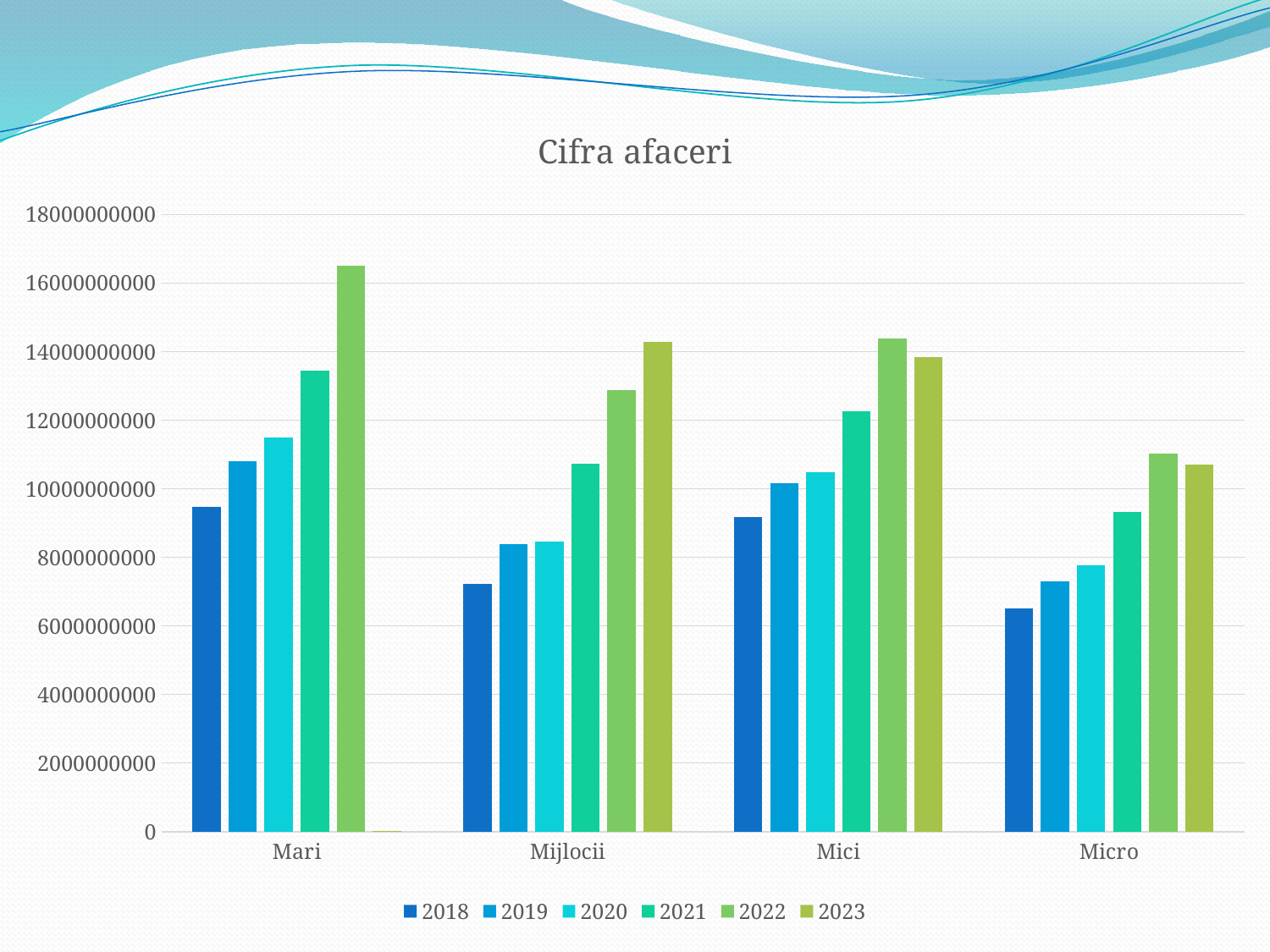
Which is larger: the 2021 value for Mari or the 2021 value for Micro? Mari Which is larger for Mici: the 2022 value or the 2023 value? 2022 Is the value for Mijlocii in 2023 greater or less than 14000000000? greater What kind of chart is shown on the slide? bar chart How many categories are shown on the x axis? 4 How many series does the legend list? 6 Which category has the highest value for the 2022 series? Mari What is the title of the chart? Cifra afaceri Which category has the lowest value for the 2018 series? Micro For the Mijlocii category, do the values rise or fall from 2018 to 2023? rise Is the value for Micro in 2018 greater or less than 8000000000? less Is the value for Mari in 2022 greater or less than 16000000000? greater